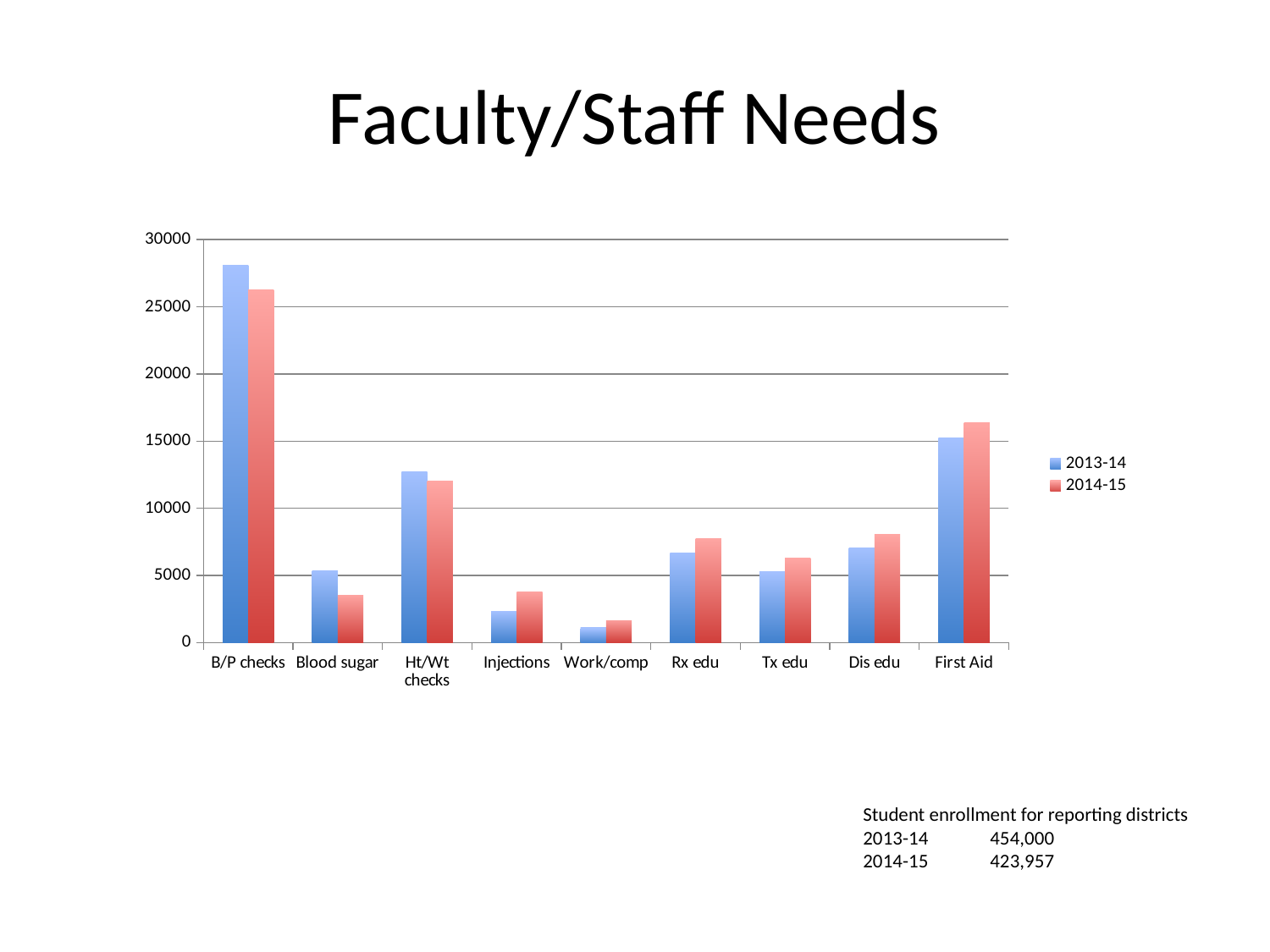
What is the title of the slide containing the chart? Faculty/Staff Needs Which category has the lowest value for the 2014-15 series? Work/comp Is the 2014-15 value for First Aid greater or less than 15000? greater How many categories are shown along the x axis? 9 For Blood sugar, which series has the larger value, 2013-14 or 2014-15? 2013-14 Is the 2013-14 value for B/P checks greater or less than 25000? greater How many series does the legend list? 2 For Injections, which series has the larger value, 2013-14 or 2014-15? 2014-15 Is the 2014-15 value for Work/comp greater or less than 5000? less What kind of chart is shown on the slide? bar chart Which category has the highest value for the 2013-14 series? B/P checks